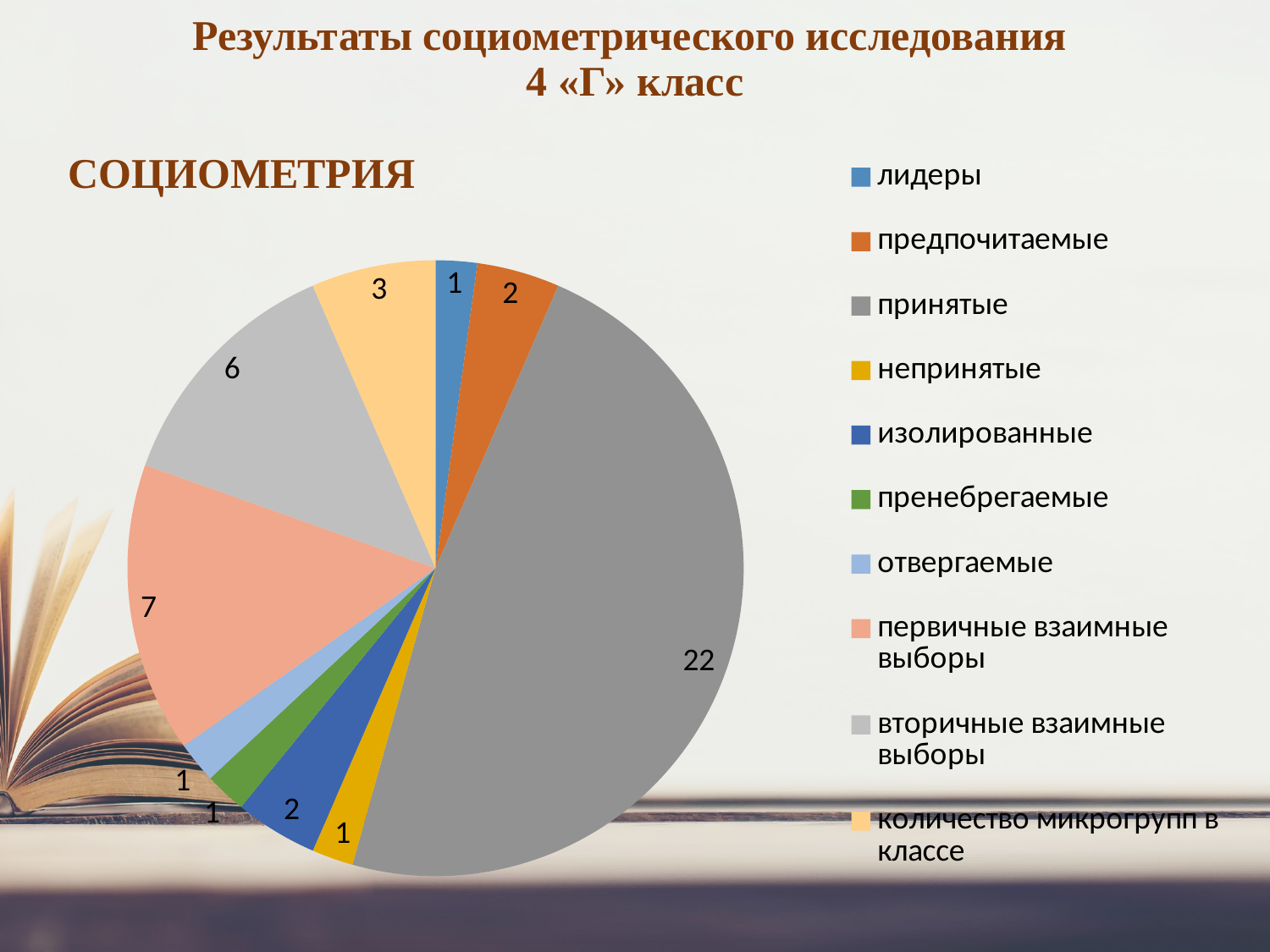
Which is larger, the value for предпочитаемые or the value for количество микрогрупп в классе? количество микрогрупп в классе What is the value for вторичные взаимные выборы? 6 How many categories does the pie chart have? 10 How many entries does the legend list? 10 What is the value for первичные взаимные выборы? 7 What kind of chart is shown on the slide? pie chart What is the value for количество микрогрупп в классе? 3 What is the title of the pie chart? СОЦИОМЕТРИЯ Which category has the largest slice of the pie? принятые What is the difference between the values for принятые and первичные взаимные выборы? 15 What is the value for принятые in the pie chart? 22 What is the value for лидеры? 1